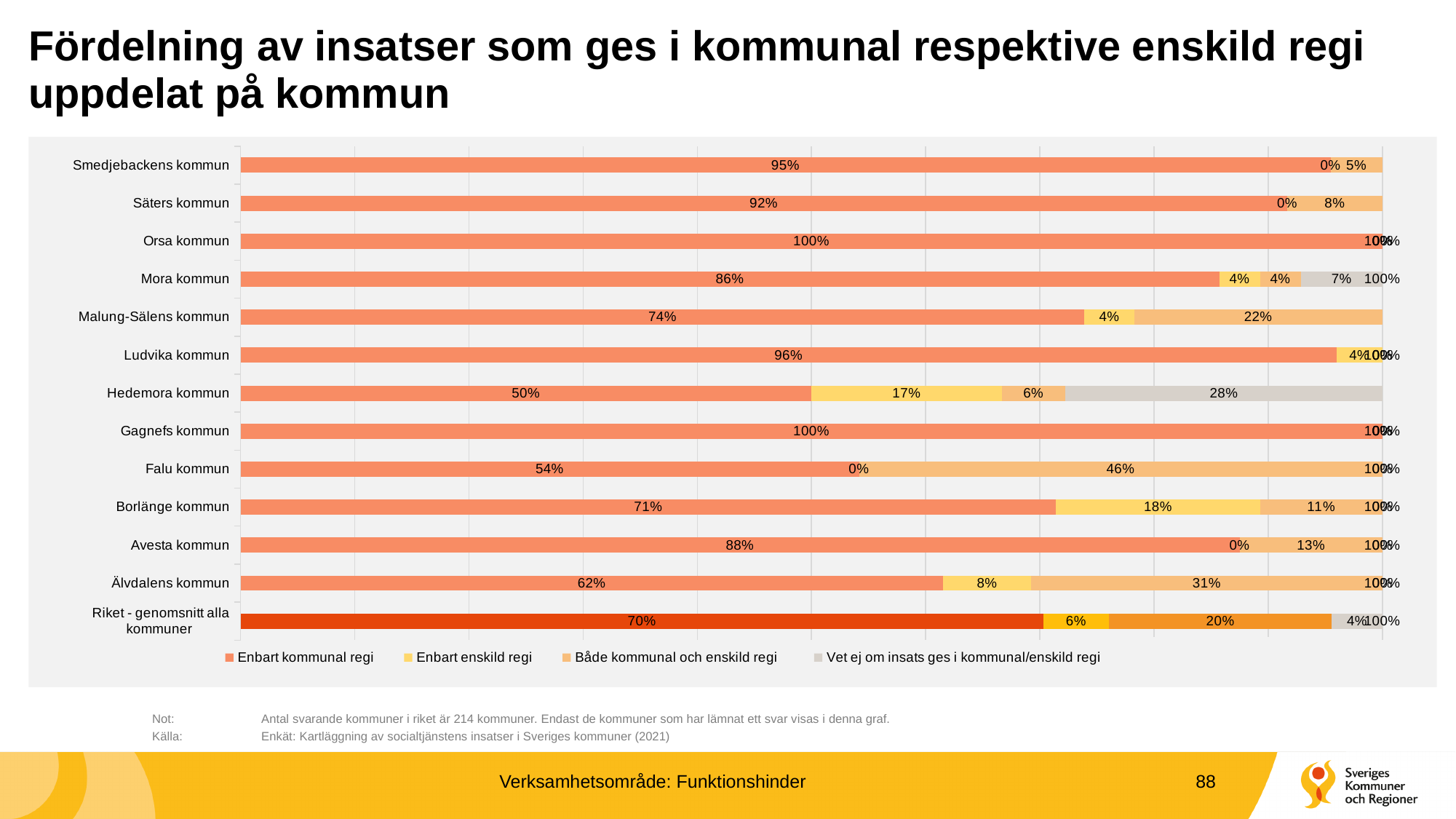
What is the value for Enbart enskild regi for Borlänge kommun? 18% Which series is shown in grey in the legend? Vet ej om insats ges i kommunal/enskild regi How many categories are shown on the y axis? 13 What kind of chart is shown on the slide? Stacked bar chart How many series does the legend list? 4 What is the difference between the Enbart kommunal regi values for Smedjebackens kommun and Säters kommun? 3% What is the value for Enbart kommunal regi for Hedemora kommun? 50% Which has a larger Både kommunal och enskild regi value, Malung-Sälens kommun or Älvdalens kommun? Älvdalens kommun What is the value for Enbart kommunal regi for Riket - genomsnitt alla kommuner? 70% Which category has the lowest value for Enbart kommunal regi? Hedemora kommun What is the value for Både kommunal och enskild regi for Falu kommun? 46% What is the value for Vet ej om insats ges i kommunal/enskild regi for Hedemora kommun? 28%